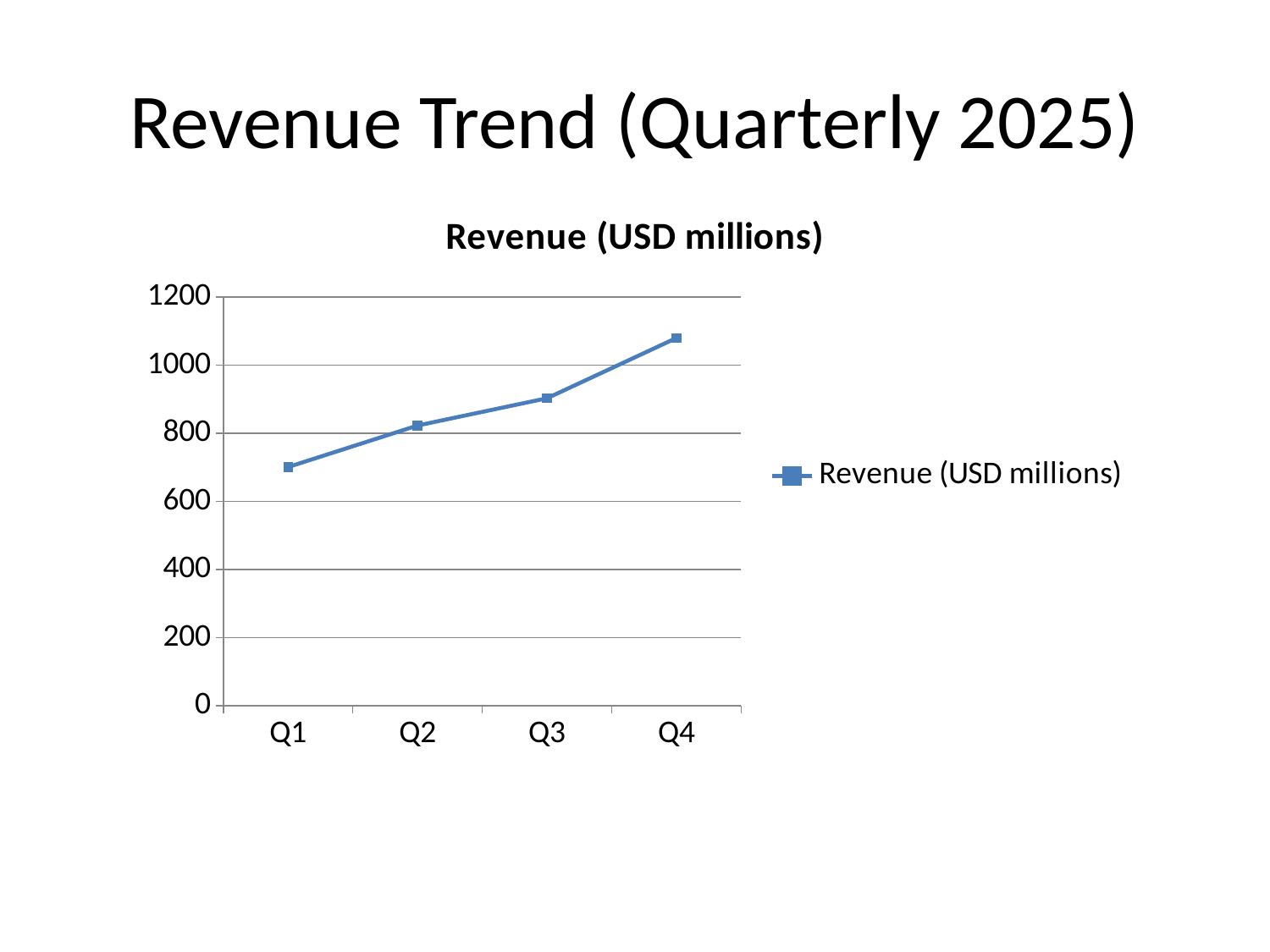
What kind of chart is shown on the slide? line chart Is the revenue for Q4 greater or less than 1000? greater How many series does the legend list? 1 Which quarter has the lowest revenue? Q1 What is the title of the chart? Revenue (USD millions) Do revenue values rise or fall from Q1 to Q4? rise How many quarters are plotted on the x axis? 4 Which quarter has the highest revenue? Q4 Is the revenue for Q1 greater or less than 600? greater Is the revenue for Q1 greater or less than 800? less Which is larger, the revenue for Q2 or the revenue for Q4? Q4